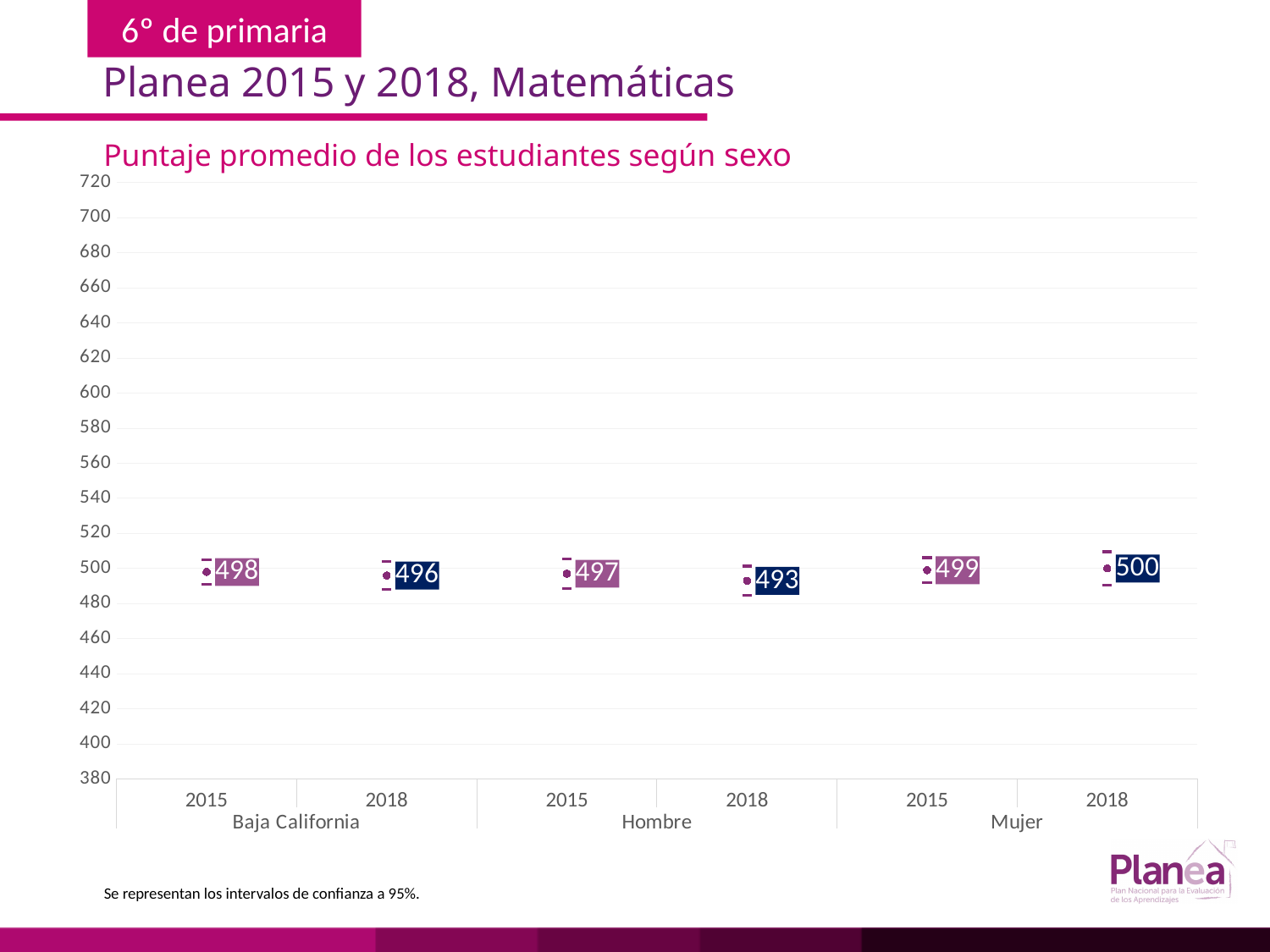
What is the difference between the Hombre scores in 2015 and 2018? 4 Which is larger, the Mujer score in 2015 or the Hombre score in 2015? Mujer 2015 What is the average score for Baja California in 2018? 496 Which group and year has the lowest average score? Hombre 2018 What is the average score for Baja California in 2015? 498 What is the difference between the Mujer and Hombre scores in 2018? 7 What is the title of the chart? Puntaje promedio de los estudiantes según sexo Did the Hombre score rise or fall from 2015 to 2018? fall What is the average score for Hombre in 2018? 493 Which group and year has the highest average score? Mujer 2018 What is the average score for Mujer in 2015? 499 How many data points are plotted on the chart? 6